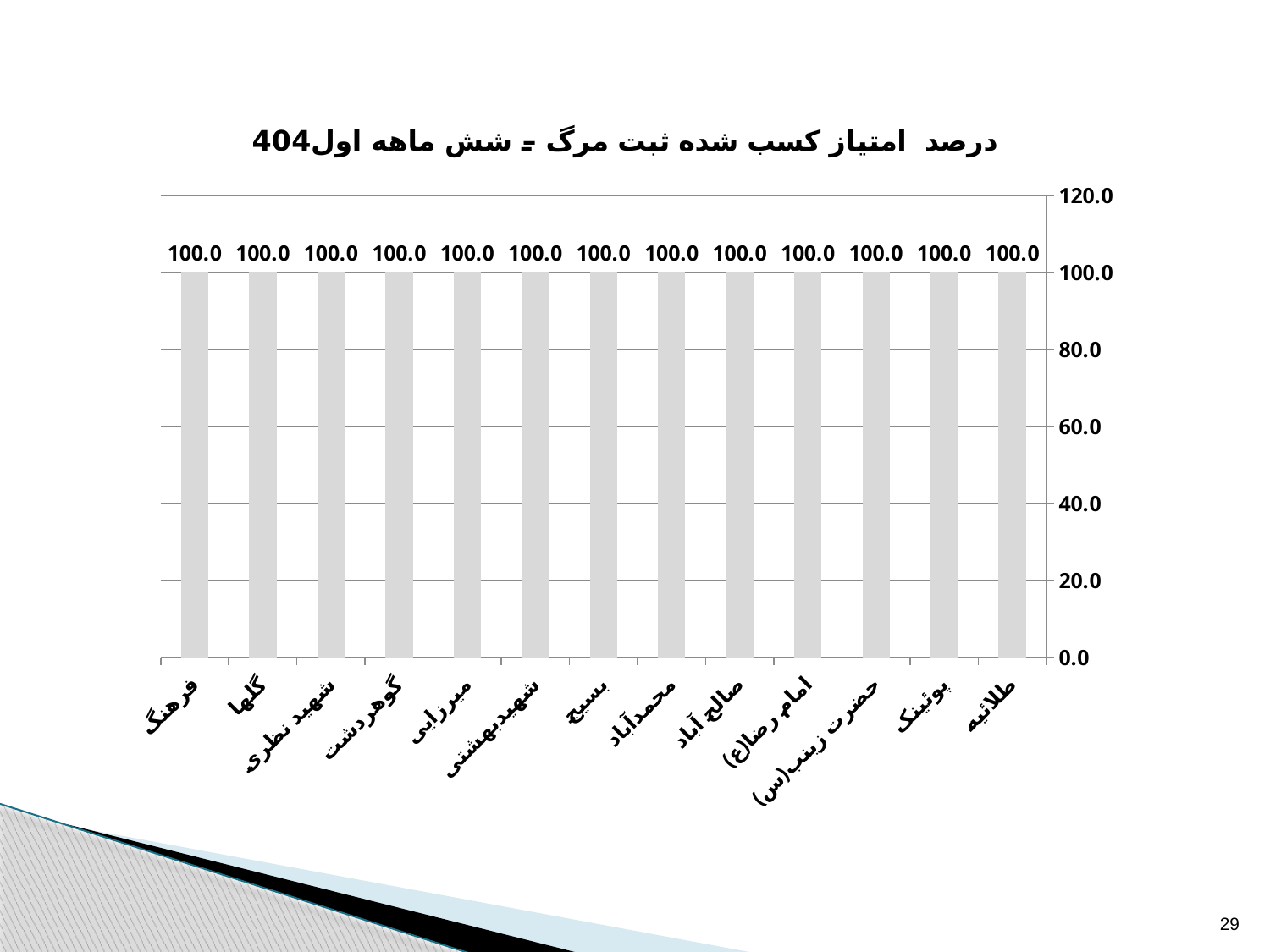
What is the title of the chart? درصد امتیاز کسب شده ثبت مرگ - شش ماهه اول404 What is the highest value shown on the y axis? 120.0 Do the values rise, fall, or stay flat across the categories? stay flat Is the value for شهیدبهشتی greater or less than 80.0? greater What is the value for طلائیه? 100.0 What is the difference between the values for گلها and محمدآباد? 0.0 What is the value for بسیج? 100.0 How many categories are shown on the x axis? 13 What is the value for فرهنگ? 100.0 What kind of chart is this? bar chart What is the value for گوهردشت? 100.0